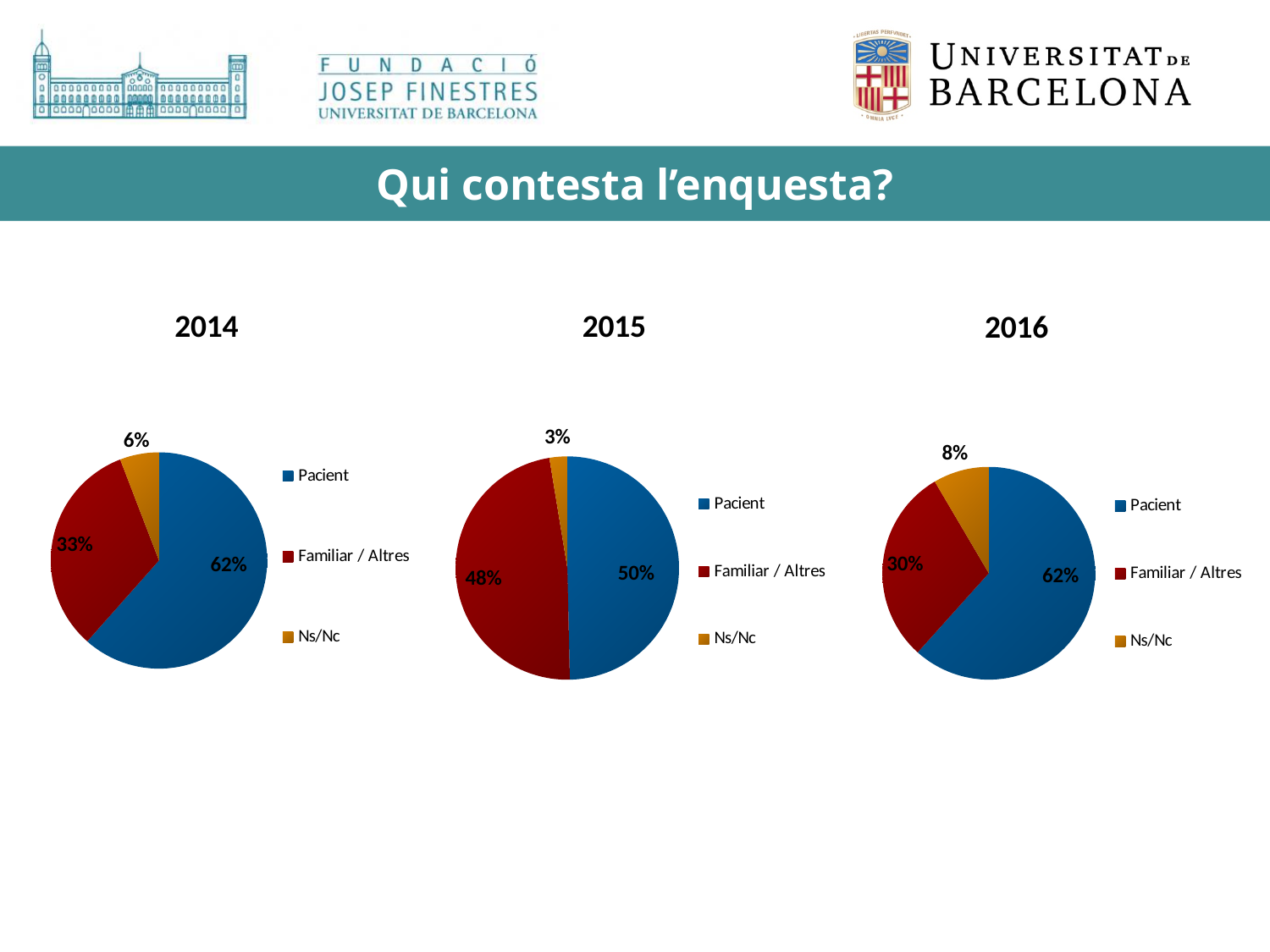
What colour represents Familiar / Altres in the pie charts? Red In the 2016 pie chart, what share of respondents were Ns/Nc? 8% In the 2015 pie chart, which is larger: the Pacient share or the Familiar / Altres share? Pacient In the 2014 pie chart, which category has the largest share? Pacient In the 2016 pie chart, what is the difference between the Pacient share and the Familiar / Altres share? 32% In the 2015 pie chart, which category has the smallest share? Ns/Nc In the 2015 pie chart, what share of respondents were Familiar / Altres? 48% What kind of chart is used for the 2015 data? Pie chart How many entries does the legend of the 2016 chart list? 3 What is the difference between the Ns/Nc share in 2014 and the Ns/Nc share in 2015? 3% How many slices does the 2014 pie chart have? 3 In the 2014 pie chart, what share of respondents were Pacient? 62%